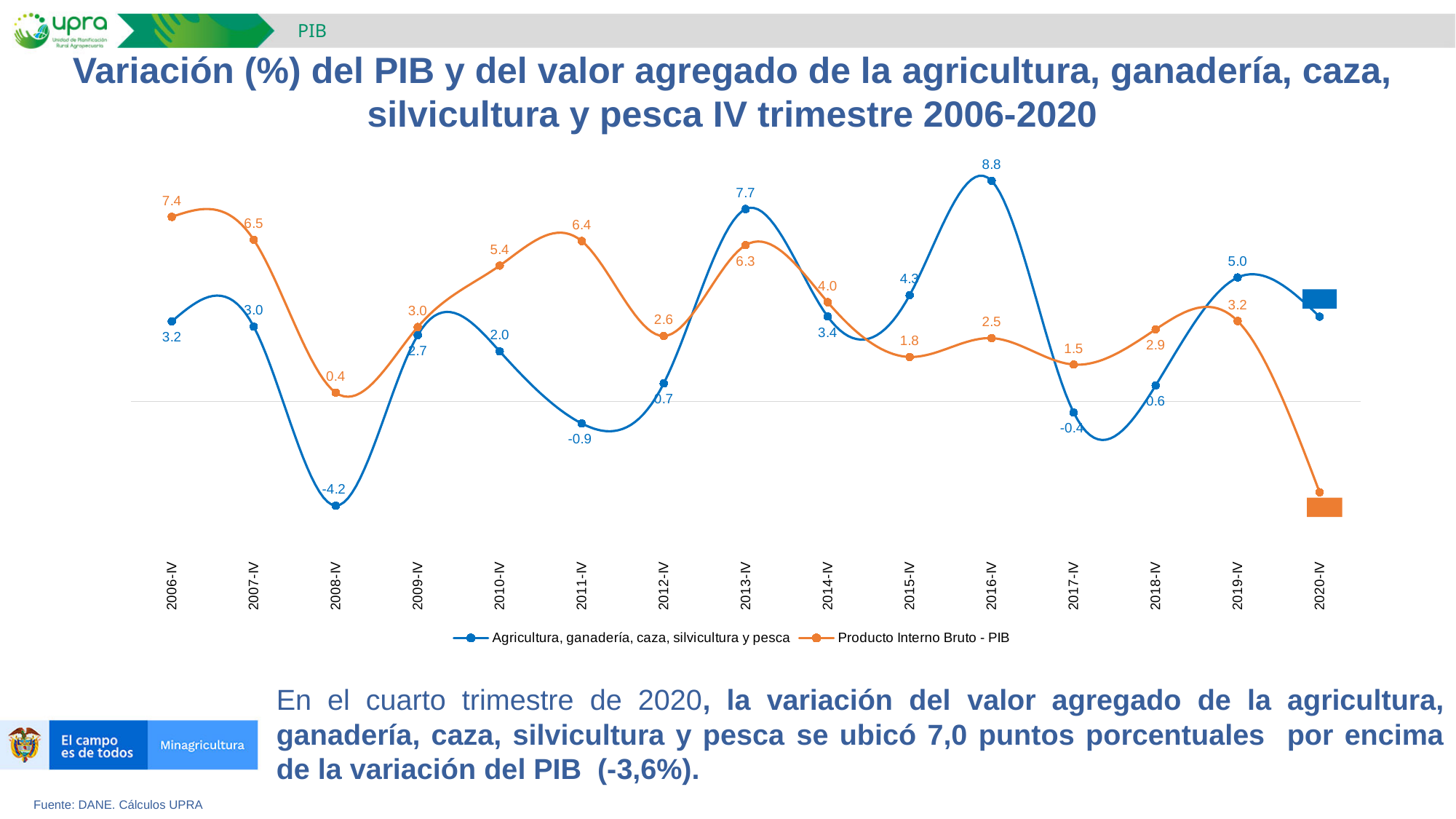
What is the value for Producto Interno Bruto - PIB in 2006-IV? 7.4 What is the difference between the Agricultura series (7.7) and the PIB series (6.3) in 2013-IV? 1.4 How many series does the legend list? 2 In which quarter does the Producto Interno Bruto - PIB series reach its highest value? 2006-IV Which colour is used for the Producto Interno Bruto - PIB series? Orange What is the value for Agricultura, ganadería, caza, silvicultura y pesca in 2008-IV? -4.2 What is the value for Agricultura, ganadería, caza, silvicultura y pesca in 2016-IV? 8.8 In 2010-IV, which series has the larger value: Agricultura, ganadería, caza, silvicultura y pesca or Producto Interno Bruto - PIB? Producto Interno Bruto - PIB In which quarter does the Agricultura, ganadería, caza, silvicultura y pesca series reach its lowest value? 2008-IV In which quarter does the Agricultura, ganadería, caza, silvicultura y pesca series reach its highest value? 2016-IV What type of chart is shown on the slide? Line chart How many quarters (x-axis categories) are plotted on the chart? 15